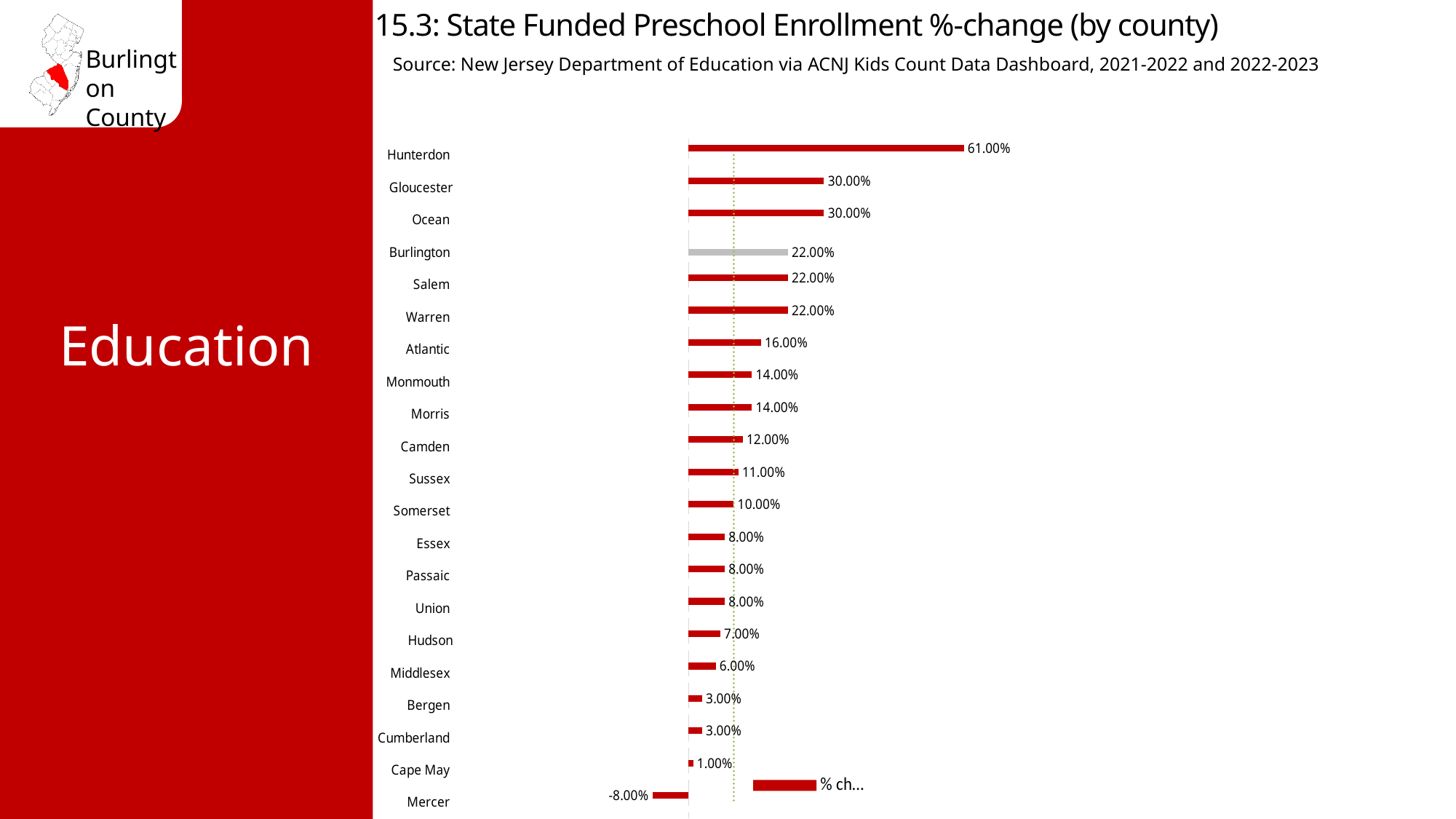
Which county has the highest value? Hunterdon What is the value for Atlantic? 16.00% Which county has the lowest value? Mercer Which is larger, the value for Ocean or the value for Salem? Ocean What is the value for Mercer? -8.00% What kind of chart is shown on the slide? Bar chart What is the value for Hunterdon? 61.00% How many counties are shown in the chart? 21 What is the difference between the values for Burlington and Camden? 10.00% What is the value for Burlington? 22.00% Which county's bar is coloured grey instead of red? Burlington What is the difference between the values for Hunterdon and Gloucester? 31.00%